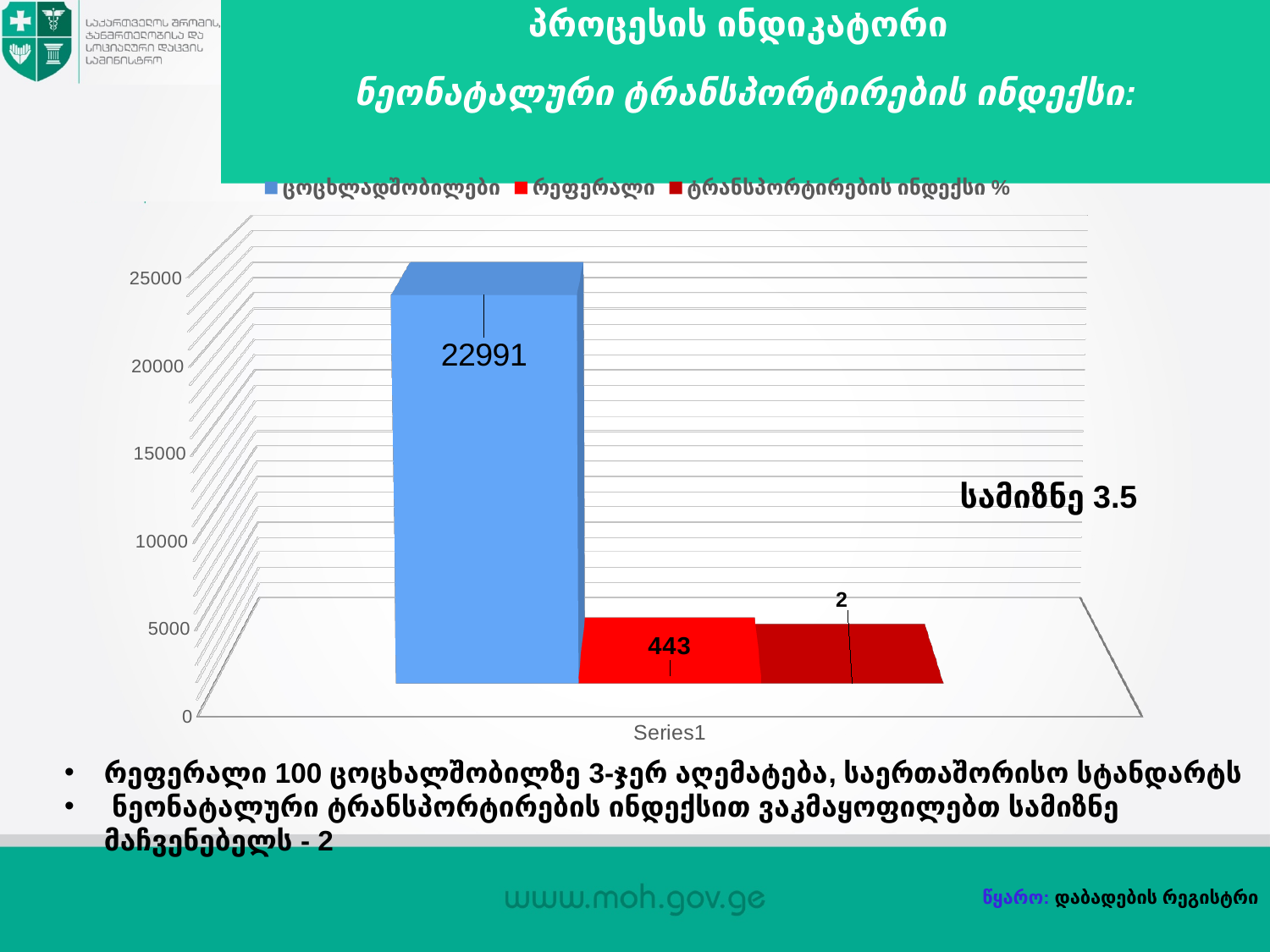
Which series has the highest value? ცოცხლადშობილები What is the difference between the values for ცოცხლადშობილები and რეფერალი? 22548 What is the value for ცოცხლადშობილები? 22991 Is the value for რეფერალი greater or less than 5000? less What is the value for რეფერალი? 443 How many series does the legend list? 3 What is the value for ტრანსპორტირების ინდექსი %? 2 What kind of chart is shown on the slide? bar chart Which is larger, the value for რეფერალი or the value for ტრანსპორტირების ინდექსი %? რეფერალი Which series has the lowest value? ტრანსპორტირების ინდექსი % Is the value for ცოცხლადშობილები greater or less than 20000? greater What is the category label shown on the x axis? Series1